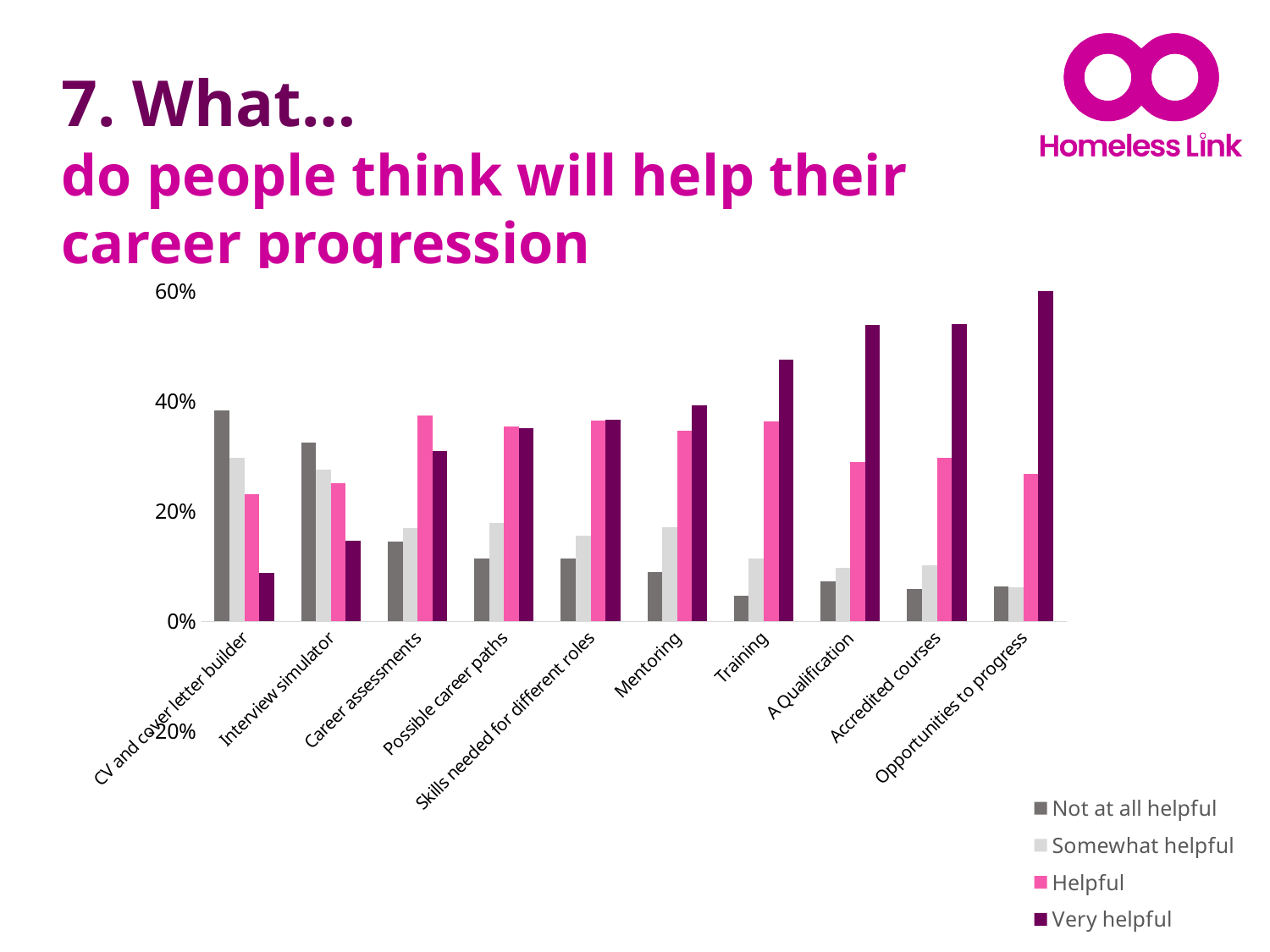
For Interview simulator, which is larger: the 'Not at all helpful' value or the 'Very helpful' value? Not at all helpful What colour represents the 'Very helpful' series in the legend? dark purple Which category has the lowest 'Very helpful' value? CV and cover letter builder Is the 'Very helpful' value for A Qualification greater or less than 40%? greater How many categories are shown along the x axis of the chart? 10 What kind of chart is shown on the slide? bar chart Is the 'Very helpful' value for CV and cover letter builder greater or less than 20%? less Which category has the highest 'Not at all helpful' value? CV and cover letter builder How many series does the chart's legend list? 4 Do the 'Very helpful' values generally rise or fall moving from left to right along the x axis? rise Which category has the highest 'Very helpful' value? Opportunities to progress Is the 'Not at all helpful' value for Training greater or less than 20%? less